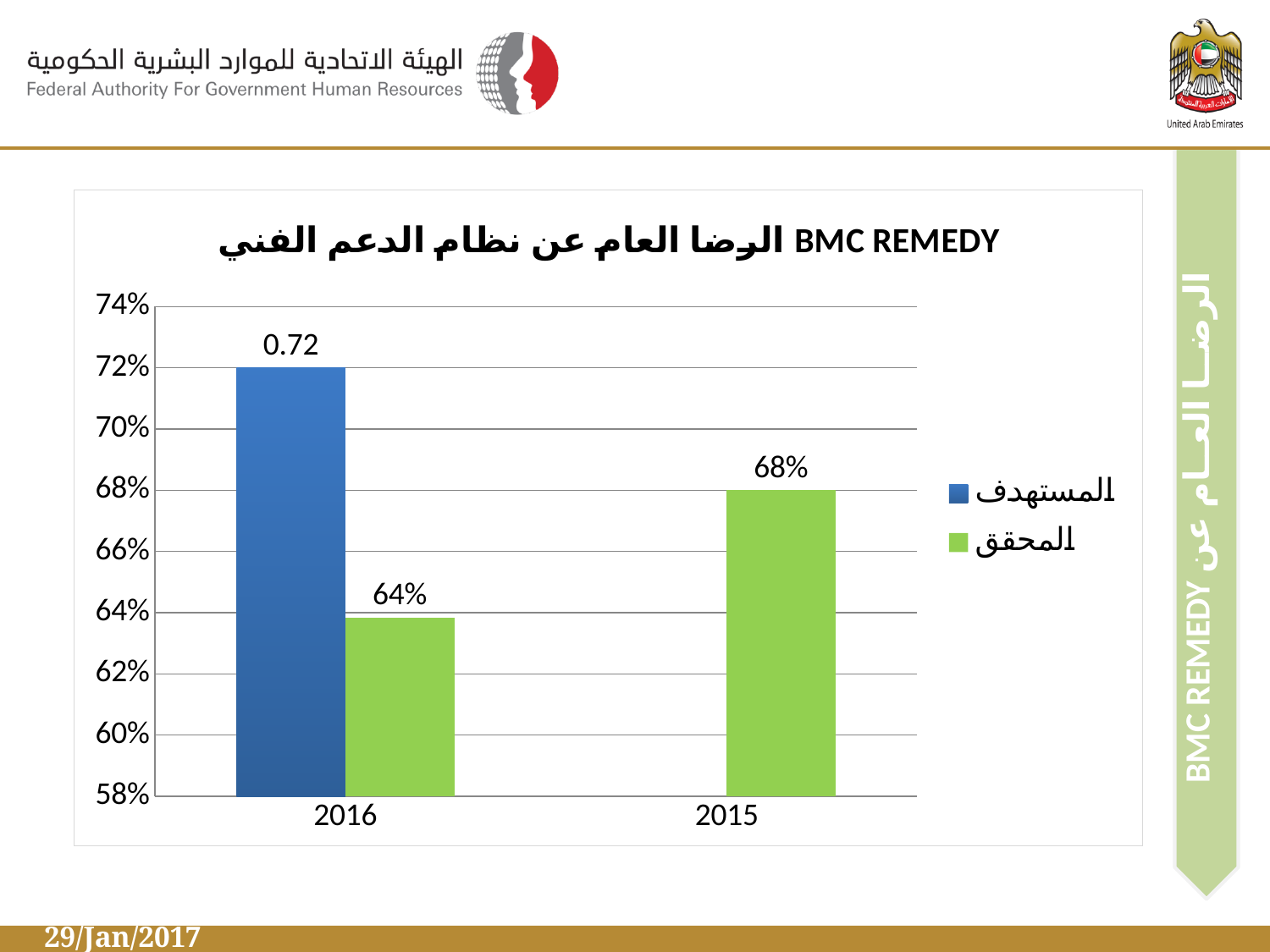
Is the المحقق (achieved) value for 2016 greater or less than 66%? less What is the difference between the المحقق (achieved) values for 2015 and 2016? 4% What is the value of المحقق (achieved) for 2016? 64% What is the value of المستهدف (target) for 2016? 0.72 How many categories are shown on the x axis? 2 Is the المستهدف (target) value for 2016 greater or less than 70%? greater What is the title of the chart? BMC REMEDY الرضا العام عن نظام الدعم الفني How many series does the legend list? 2 Which year has the higher المحقق (achieved) value, 2016 or 2015? 2015 What type of chart is shown on the slide? bar chart What is the value of المحقق (achieved) for 2015? 68% Which series is shown in blue in the legend? المستهدف